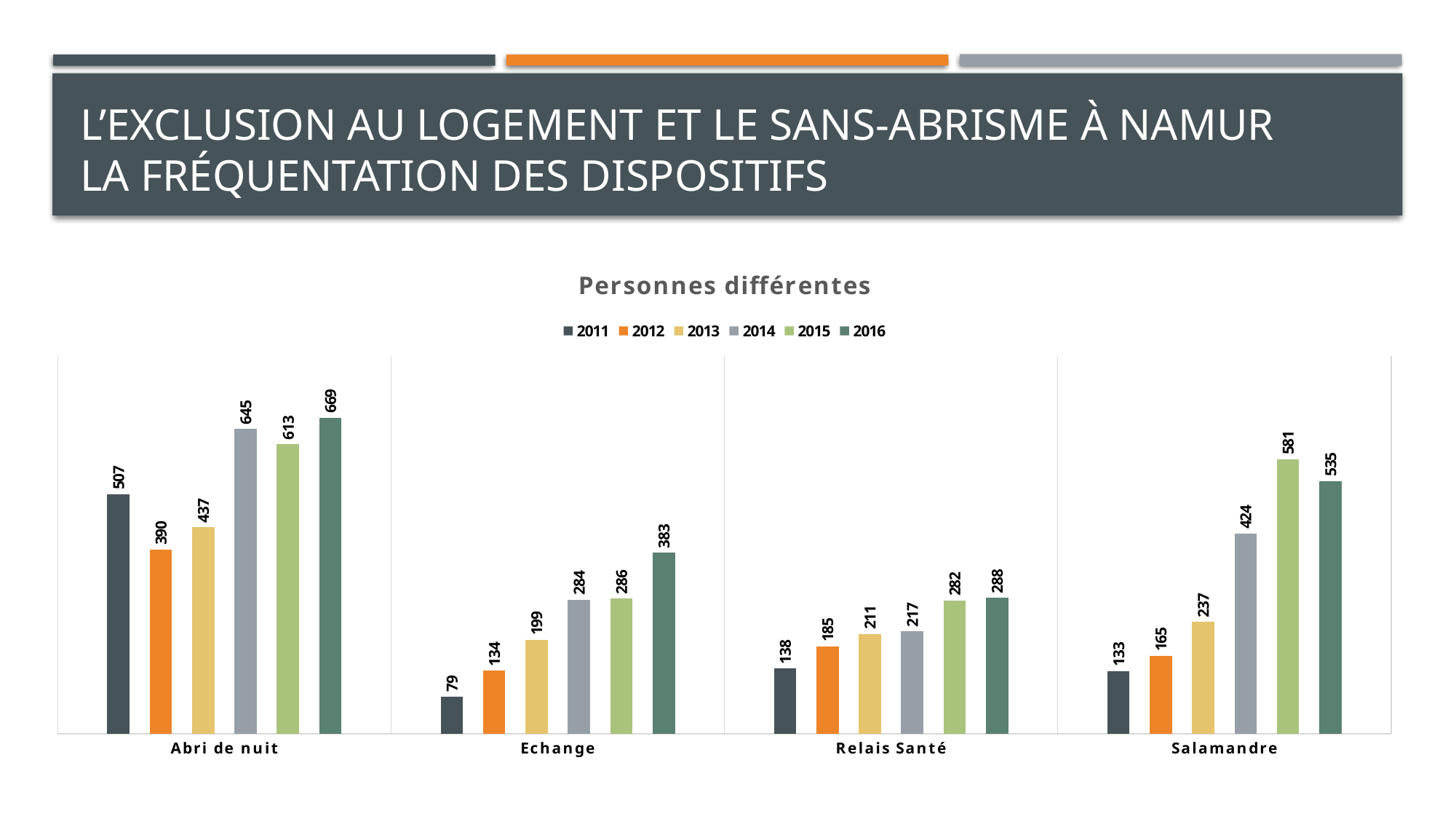
Which category has the lowest value in 2012? Echange What is the title of the chart? Personnes différentes Which is larger for Abri de nuit: the 2014 value or the 2015 value? 2014 How many categories are shown on the x axis? 4 Which category has the highest value in 2015? Abri de nuit What kind of chart is shown on the slide? Bar chart What is the value for Abri de nuit in 2016? 669 What is the difference between the 2016 and 2011 values for Salamandre? 402 How many series does the legend list? 6 What is the value for Echange in 2011? 79 What is the value for Salamandre in 2014? 424 What is the value for Relais Santé in 2013? 211